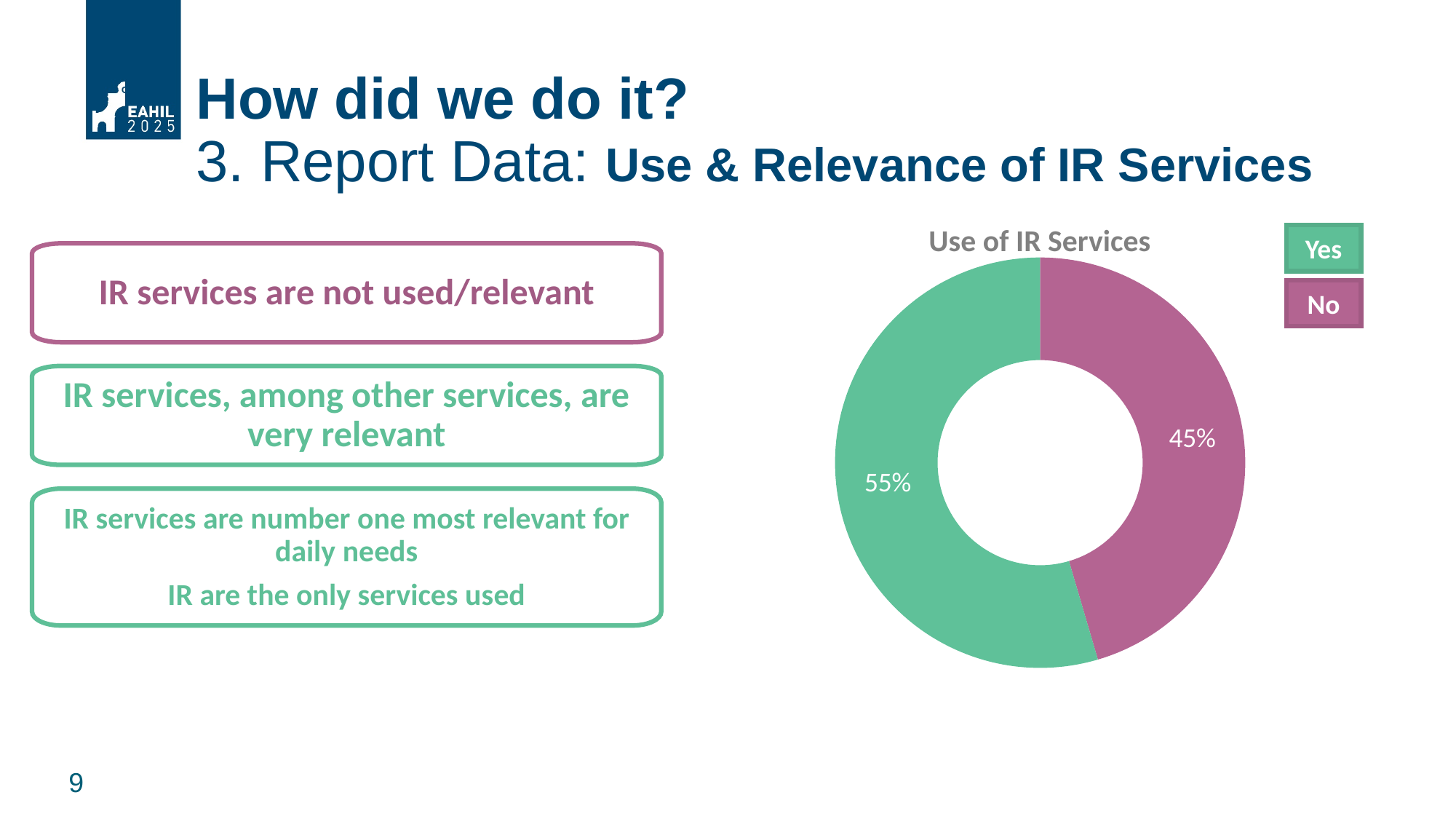
What colour represents 'No' in the chart? Purple (magenta) What percentage of the chart is labelled 'Yes'? 55% What is the title of the chart? Use of IR Services What percentage of the chart is labelled 'No'? 45% How many slices does the chart have? 2 What is the difference in percentage points between the Yes and No shares? 10 What kind of chart is shown on the slide? Doughnut (pie) chart How many categories does the legend list? 2 Which category has the larger share, Yes or No? Yes Which category has the largest share in the chart? Yes Is the share for 'Yes' greater or less than 50%? greater Which category has the smallest share in the chart? No